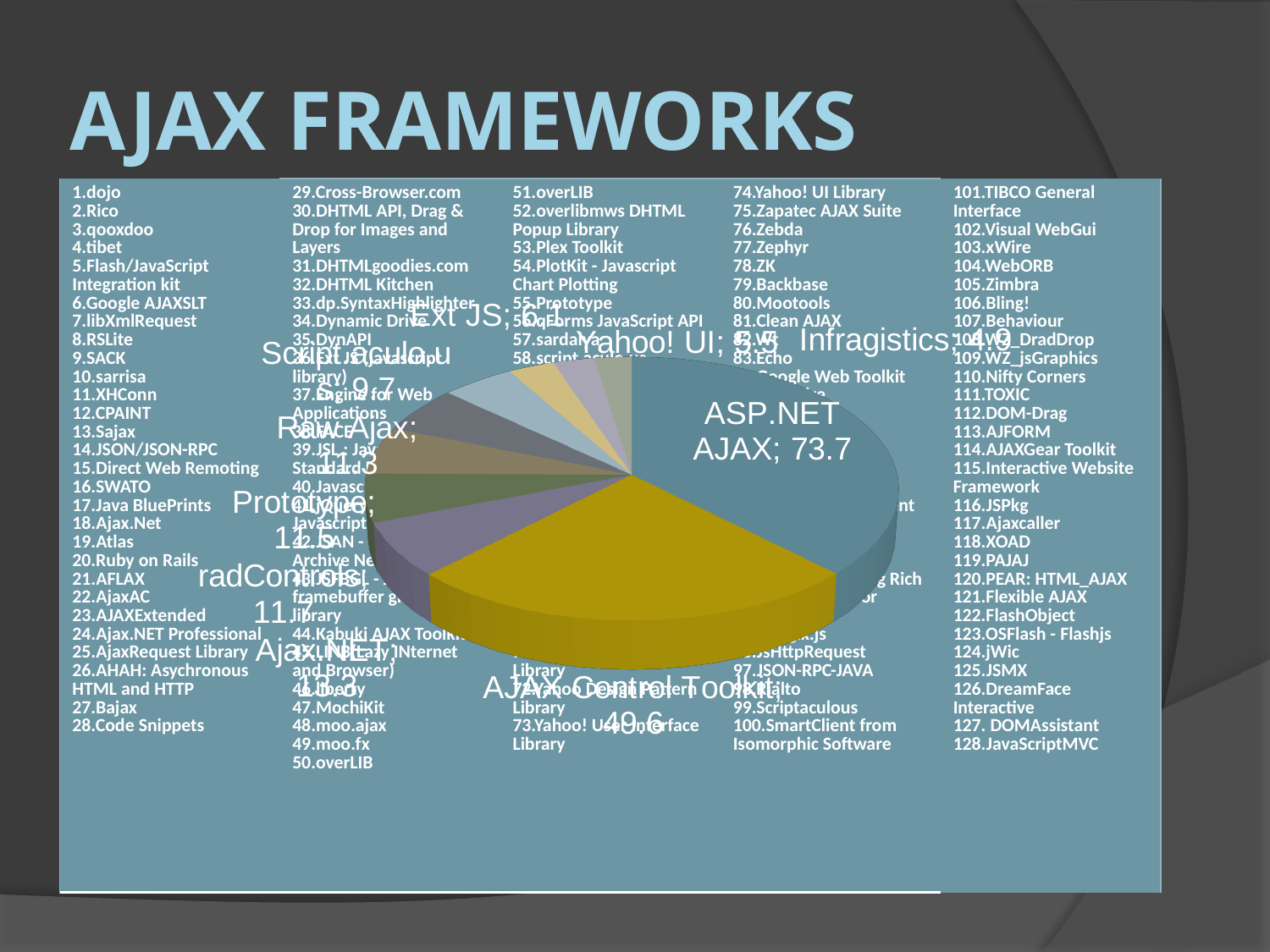
What is the value shown for ASP.NET AJAX? 73.7 What kind of chart is shown on the slide? pie chart What is the value shown for Ext JS? 6.1 What is the value shown for Prototype? 11.5 What is the value shown for Ajax.NET? 13.3 Which has the larger value, Yahoo! UI or Ext JS? Ext JS Which slice of the pie chart has the largest value? ASP.NET AJAX What is the value shown for Script.aculo.us? 9.7 What is the value shown for Infragistics? 4.9 What is the difference between the values for ASP.NET AJAX and AJAX Control Toolkit? 24.1 What is the value shown for AJAX Control Toolkit? 49.6 Which has the larger value, Prototype or Raw Ajax? Prototype